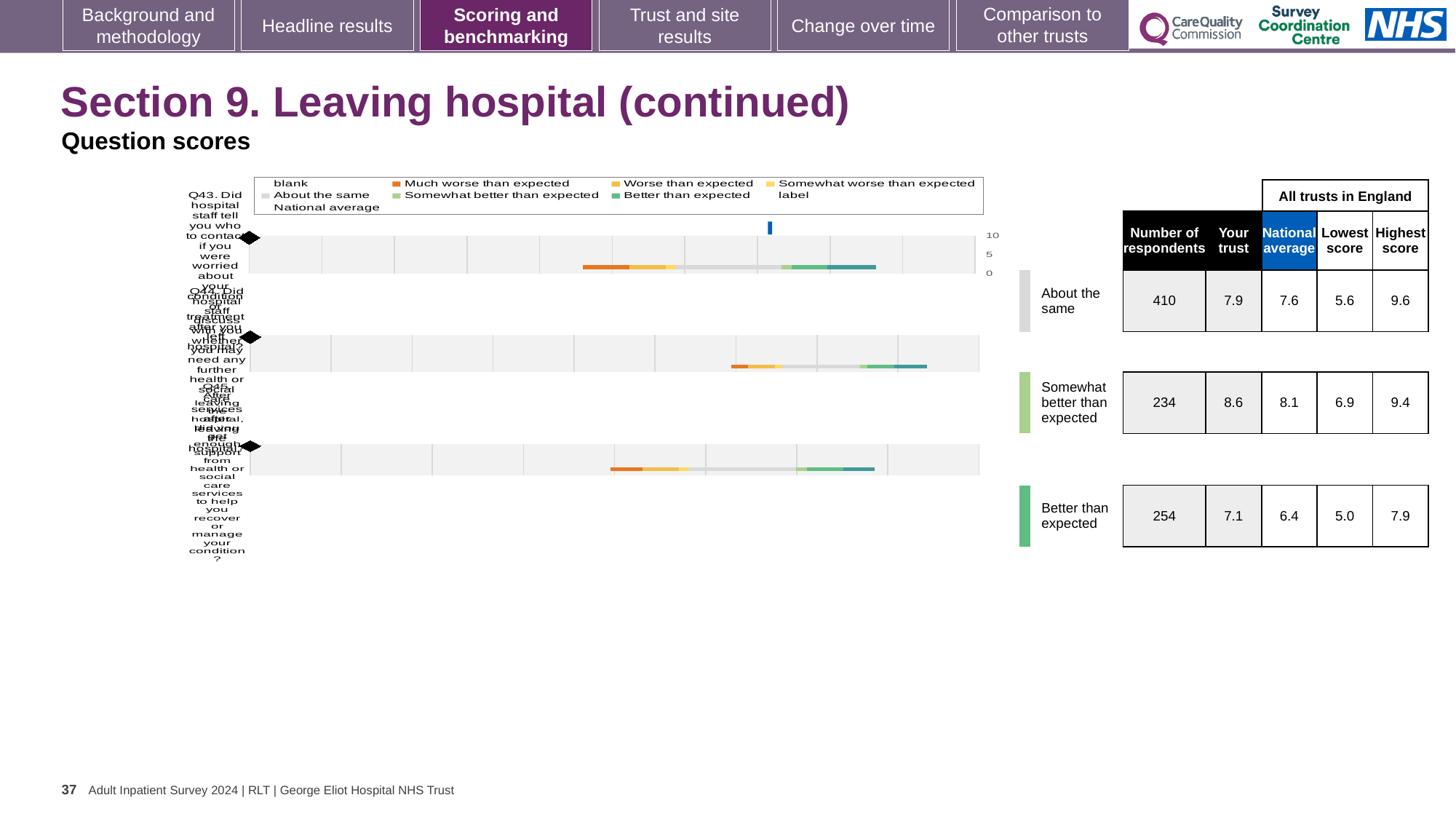
What is the national average score for the row rated 'Better than expected'? 6.4 What is the highest score among all trusts in England for the row rated 'About the same'? 9.6 What is the lowest score among all trusts in England for the row rated 'Better than expected'? 5.0 What kind of chart is shown on the slide? Bar chart What is the title of the slide containing the chart? Section 9. Leaving hospital (continued) Which rating row has the highest 'Your trust' score? Somewhat better than expected What is the 'Your trust' score for the row rated 'Somewhat better than expected'? 8.6 In the table beside the chart, how many respondents are listed for the row rated 'About the same'? 410 For the row rated 'Better than expected', which is larger: the 'Your trust' score or the national average? Your trust For the row rated 'About the same', what is the difference between the 'Your trust' score and the national average? 0.3 How many question rows are plotted in the chart? 3 Which rating row has the fewest respondents? Somewhat better than expected